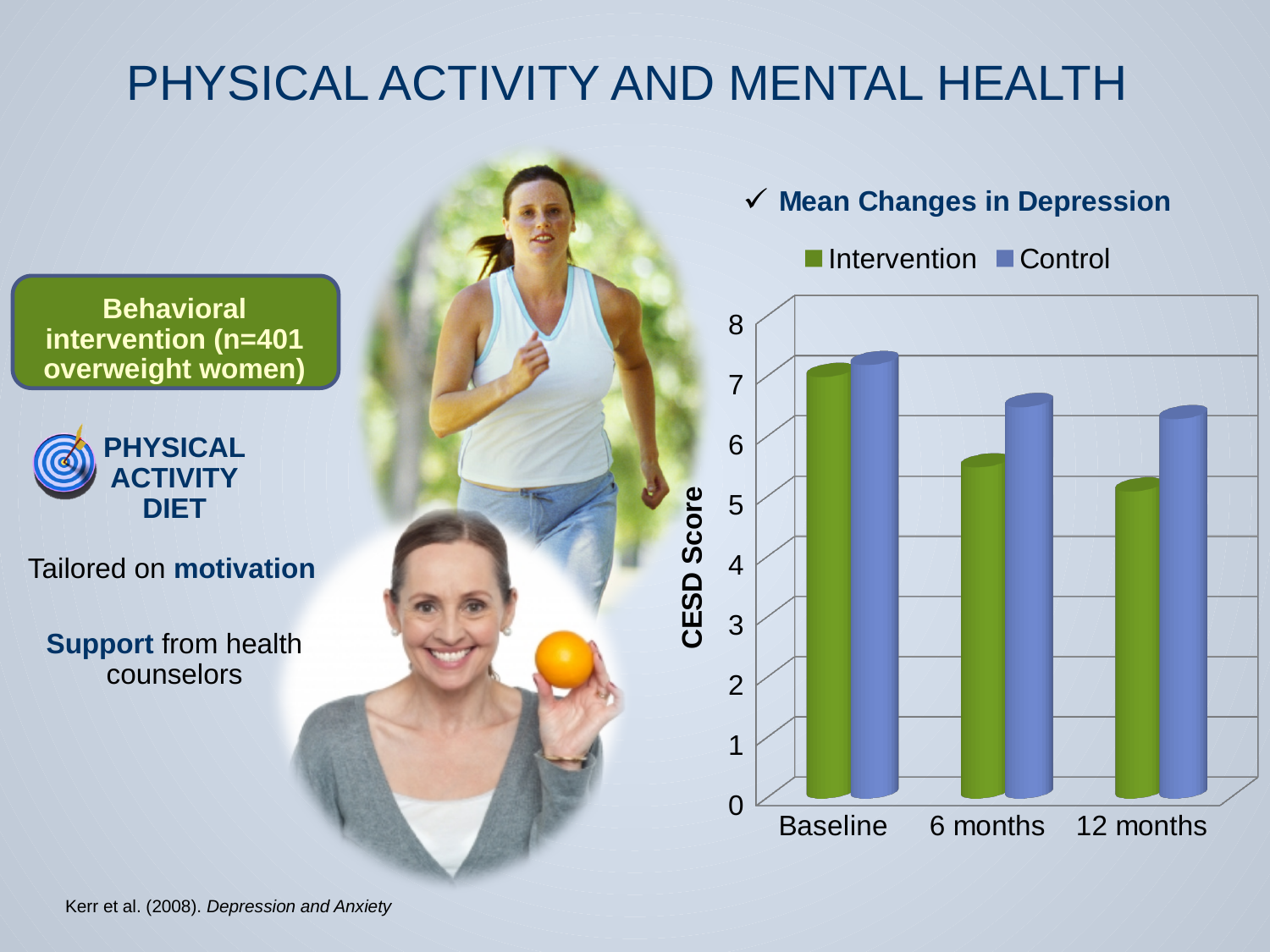
Is the Intervention value at 12 months greater or less than 6? less Is the Intervention value at 6 months greater or less than 6? less Do the Intervention values rise or fall from Baseline to 12 months? fall At which time point is the Intervention CESD Score lowest? 12 months At 6 months, which series has the higher CESD Score, Intervention or Control? Control How many series does the legend of the chart list? 2 At 12 months, which series has the higher CESD Score, Intervention or Control? Control How many time points (categories) are shown on the x axis of the chart? 3 Is the Control value at 6 months greater or less than 6? greater What is the title of the chart? Mean Changes in Depression What kind of chart is shown on the slide? Bar chart What is the label of the vertical axis of the chart? CESD Score